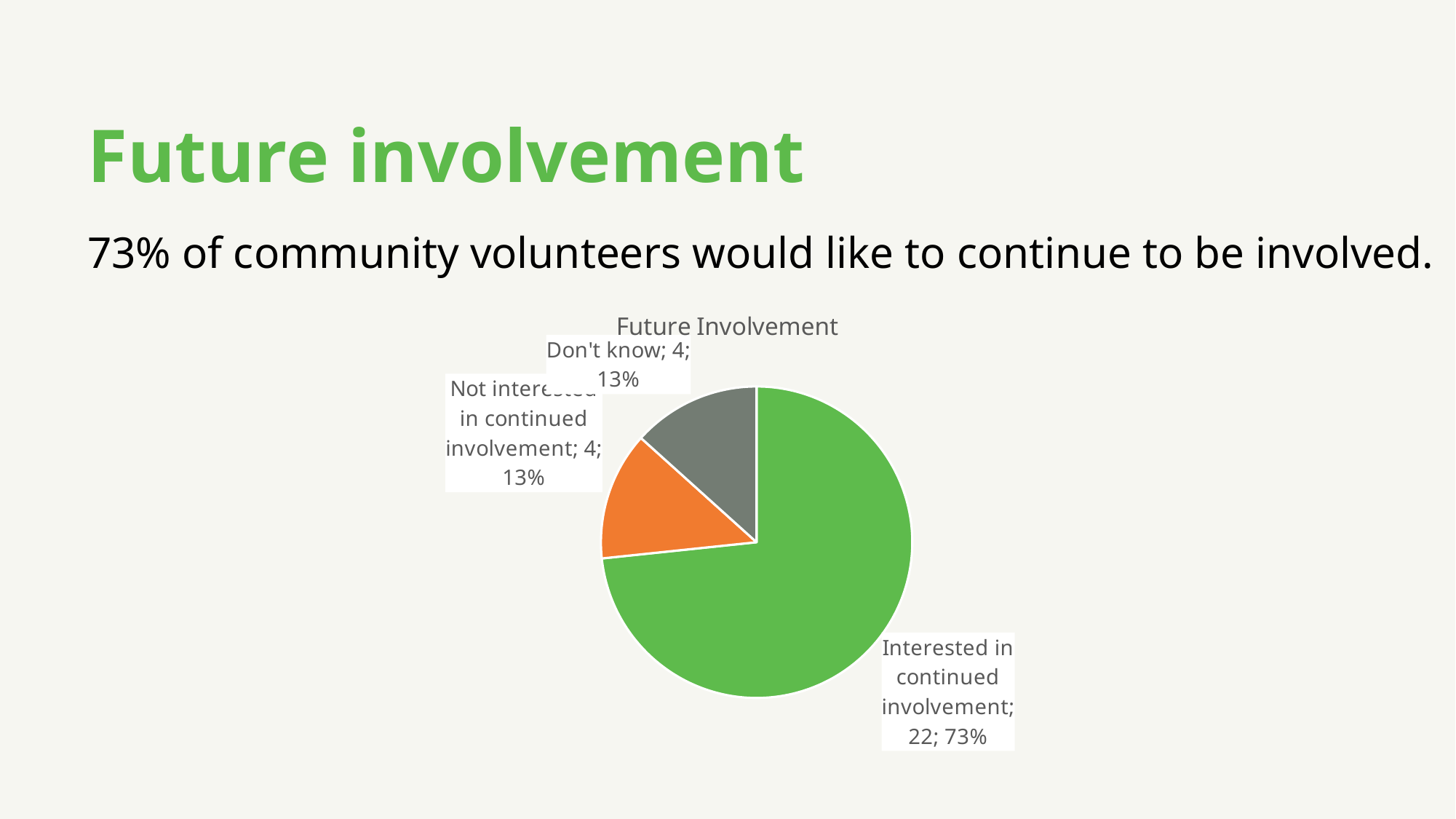
How many slices does the pie chart have? 3 What percentage share does the 'Not interested in continued involvement' slice have? 13% What is the difference in count between 'Interested in continued involvement' and 'Don't know'? 18 Which slice is the largest? Interested in continued involvement What percentage share does the 'Interested in continued involvement' slice have? 73% What percentage share does the 'Don't know' slice have? 13% What kind of chart is shown on the slide? pie chart How many respondents are in the 'Don't know' slice? 4 Which is larger, the 'Interested in continued involvement' slice or the 'Not interested in continued involvement' slice? Interested in continued involvement What is the title of the chart? Future Involvement How many respondents are in the 'Interested in continued involvement' slice? 22 What colour is the 'Interested in continued involvement' slice? green